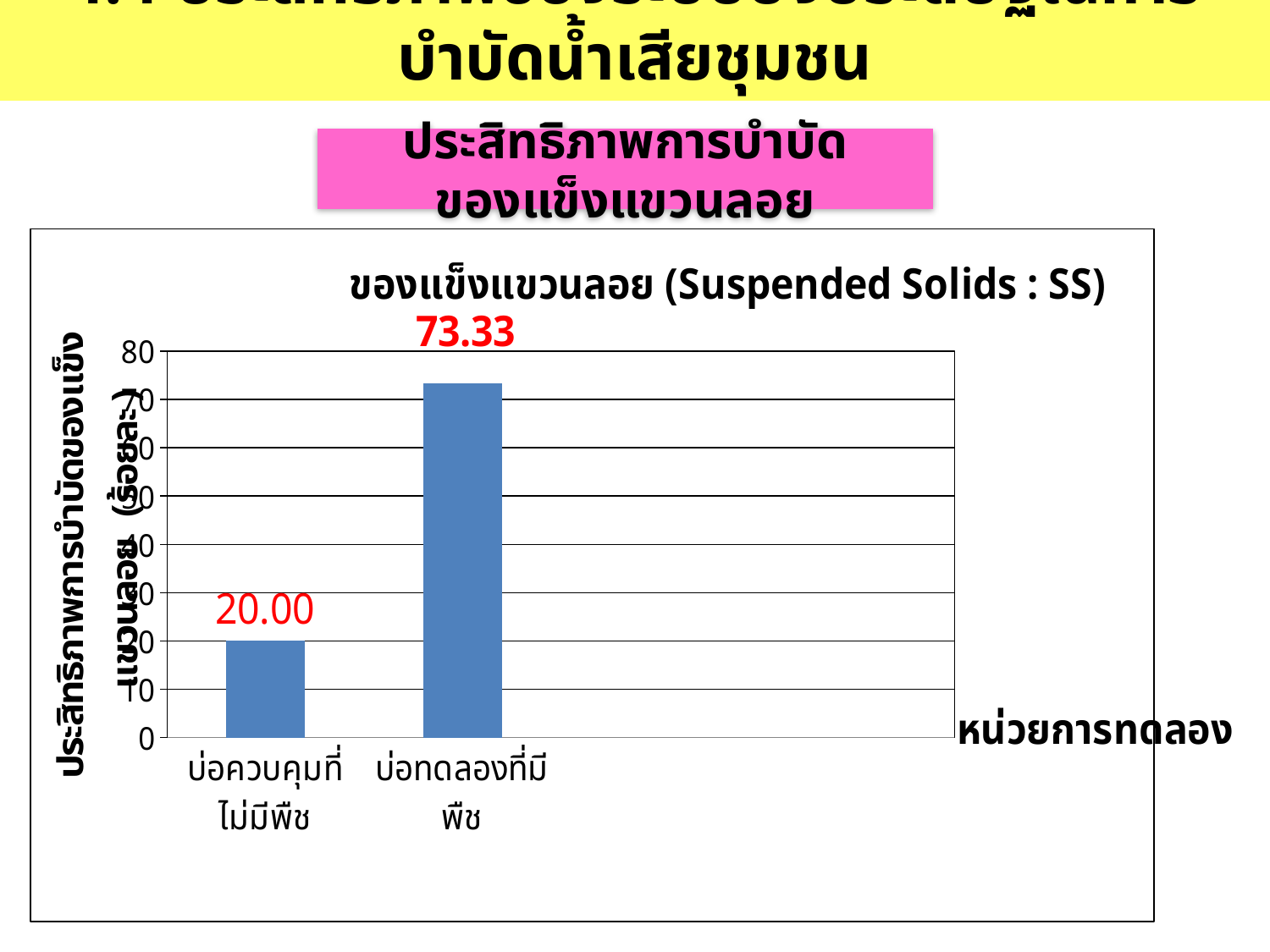
What is the title of the chart? ของแข็งแขวนลอย (Suspended Solids : SS) What is the value for บ่อทดลองที่มีพืช? 73.33 Which is larger, the value for บ่อควบคุมที่ไม่มีพืช or the value for บ่อทดลองที่มีพืช? บ่อทดลองที่มีพืช What kind of chart is shown on the slide? bar chart What is the difference between the values for บ่อทดลองที่มีพืช and บ่อควบคุมที่ไม่มีพืช? 53.33 Which category has the lowest value? บ่อควบคุมที่ไม่มีพืช How many categories are shown on the x axis? 2 Is the value for บ่อทดลองที่มีพืช greater or less than 60? greater What is the label of the x axis? หน่วยการทดลอง Which category has the highest value? บ่อทดลองที่มีพืช What is the value for บ่อควบคุมที่ไม่มีพืช? 20.00 Is the value for บ่อควบคุมที่ไม่มีพืช greater or less than 40? less